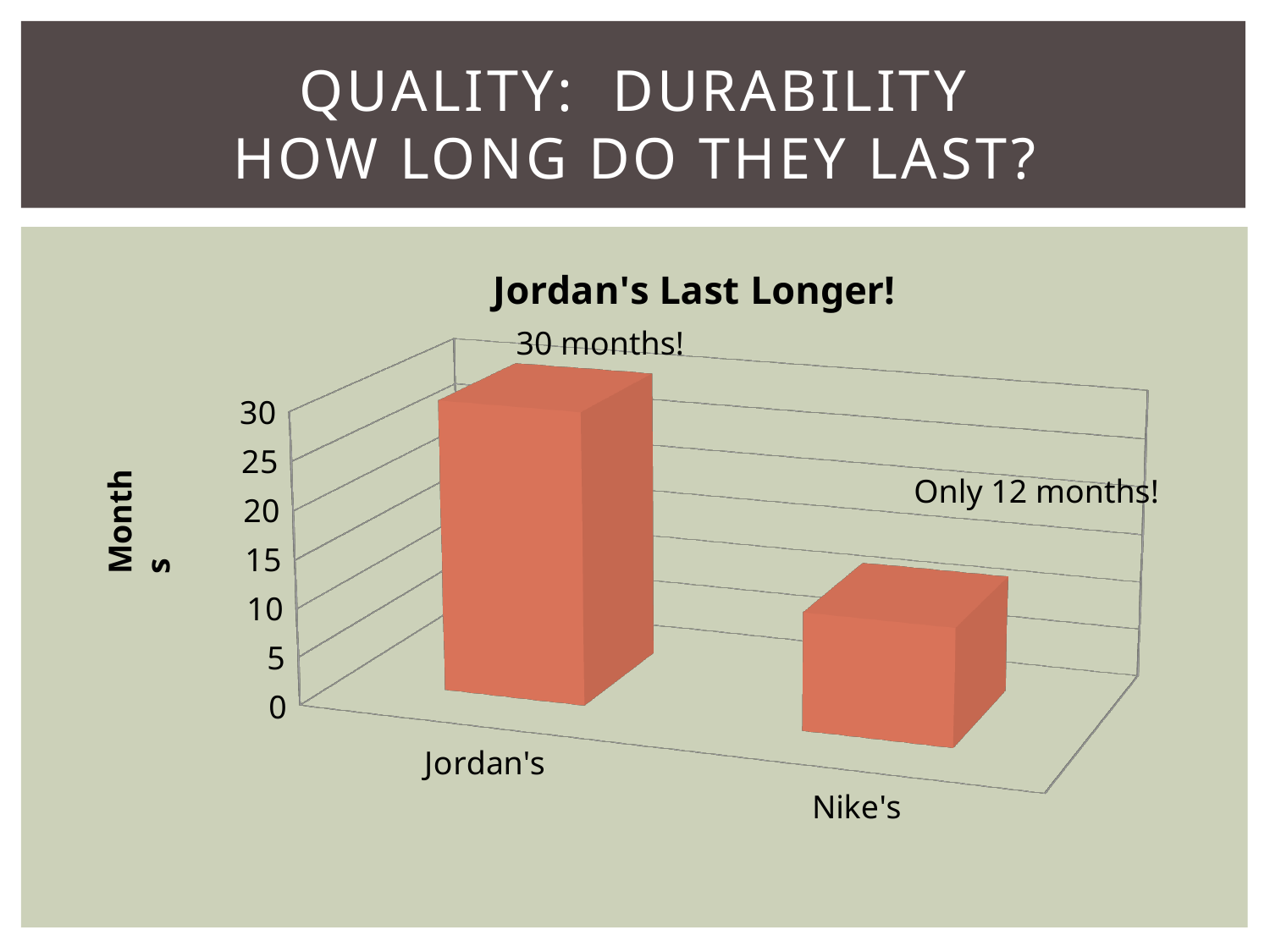
Is the value for Nike's greater or less than 15? less What is the label on the vertical axis of the chart? Months What is the title of the chart? Jordan's Last Longer! How many months do Nike's last according to the chart? 12 months What kind of chart is shown on the slide? bar chart Is the value for Jordan's greater or less than 25? greater Which category has the highest value in the chart? Jordan's Which lasts longer according to the chart, Jordan's or Nike's? Jordan's Which category has the lowest value in the chart? Nike's How many more months do Jordan's last than Nike's? 18 months How many months do Jordan's last according to the chart? 30 months How many categories are shown in the chart? 2